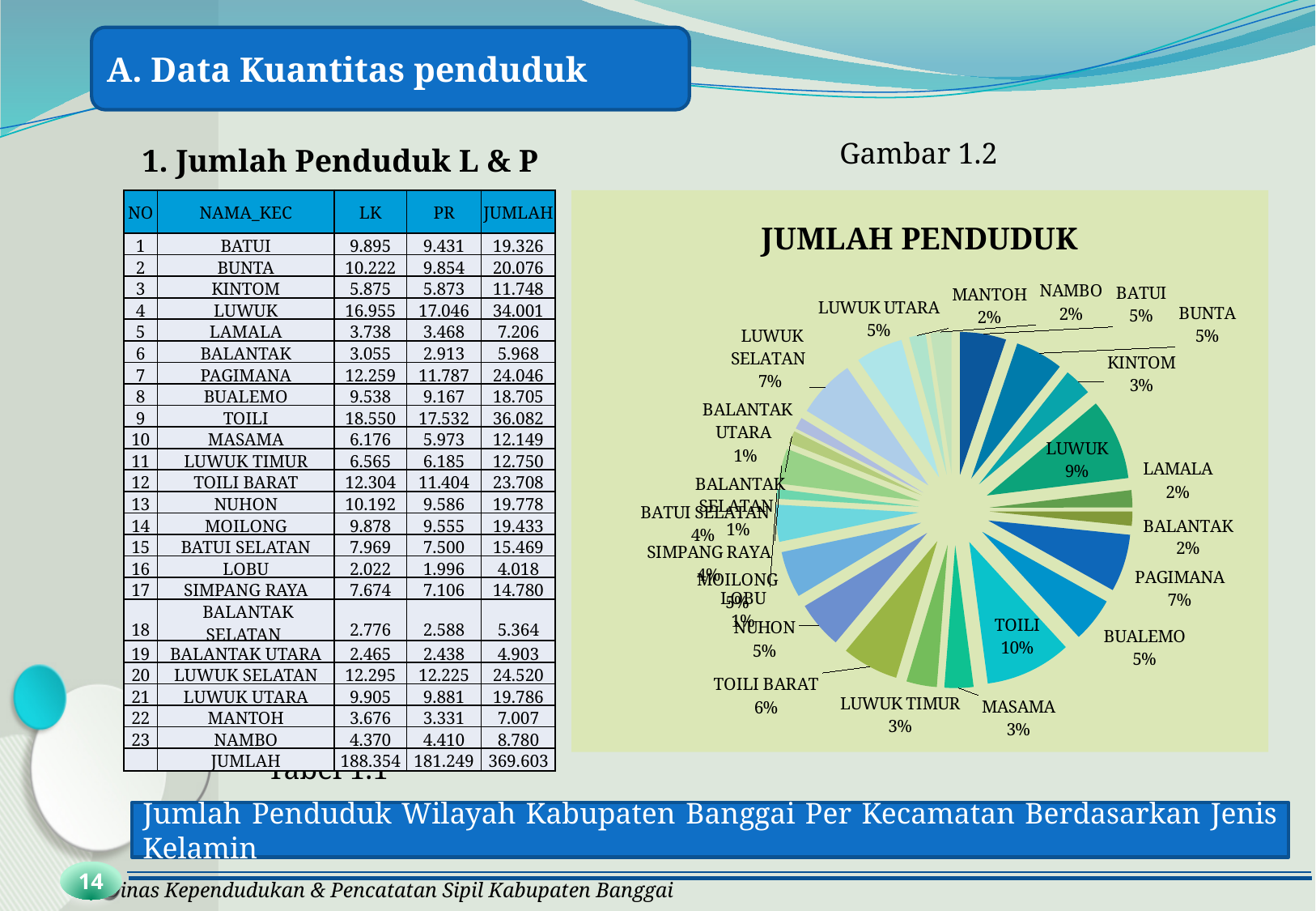
What percentage is shown for TOILI BARAT in the pie chart? 6% What percentage is shown for PAGIMANA in the pie chart? 7% What is the title of the chart? JUMLAH PENDUDUK What share of the pie chart does TOILI represent? 10% What percentage is shown for LUWUK in the pie chart? 9% Which kecamatan has the largest slice in the pie chart? TOILI Which has a larger share in the pie chart, LUWUK or PAGIMANA? LUWUK What type of chart is shown on the slide? Pie chart How many slices does the pie chart have? 23 What is the difference between the percentages shown for TOILI and LUWUK in the pie chart? 1% What percentage is shown for LUWUK SELATAN in the pie chart? 7% What percentage is shown for KINTOM in the pie chart? 3%